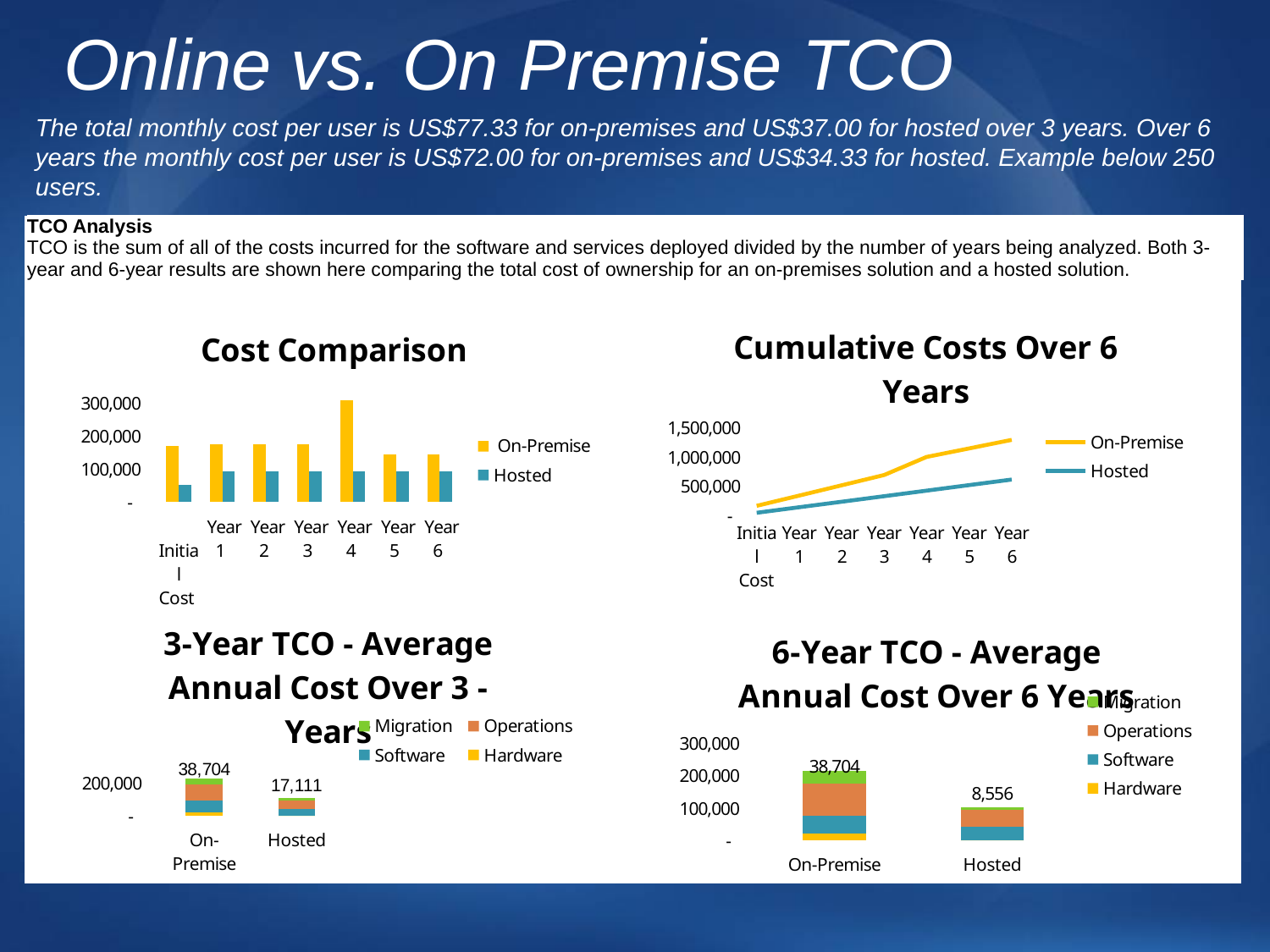
In the "Cumulative Costs Over 6 Years" chart, do the On-Premise values rise or fall from Initial Cost to Year 6? Rise In the "3-Year TCO - Average Annual Cost Over 3 Years" chart, what value is labelled on the Hosted bar? 17,111 In the "6-Year TCO - Average Annual Cost Over 6 Years" chart, what value is labelled on the Hosted bar? 8,556 In the "Cumulative Costs Over 6 Years" chart, which series is higher at Year 6, On-Premise or Hosted? On-Premise How many series does the legend of the "Cost Comparison" chart list? 2 In the "Cost Comparison" chart, is the Hosted value for Initial Cost greater or less than 100,000? less What kind of chart is the "Cumulative Costs Over 6 Years" chart? Line chart In the "Cost Comparison" chart, which category has the highest On-Premise value? Year 4 In the "Cost Comparison" chart, is the On-Premise value for Year 4 greater or less than 200,000? greater How many categories are shown on the x axis of the "Cost Comparison" chart? 7 How many series does the legend of the "6-Year TCO - Average Annual Cost Over 6 Years" chart list? 4 What kind of chart is the "Cost Comparison" chart? Bar chart